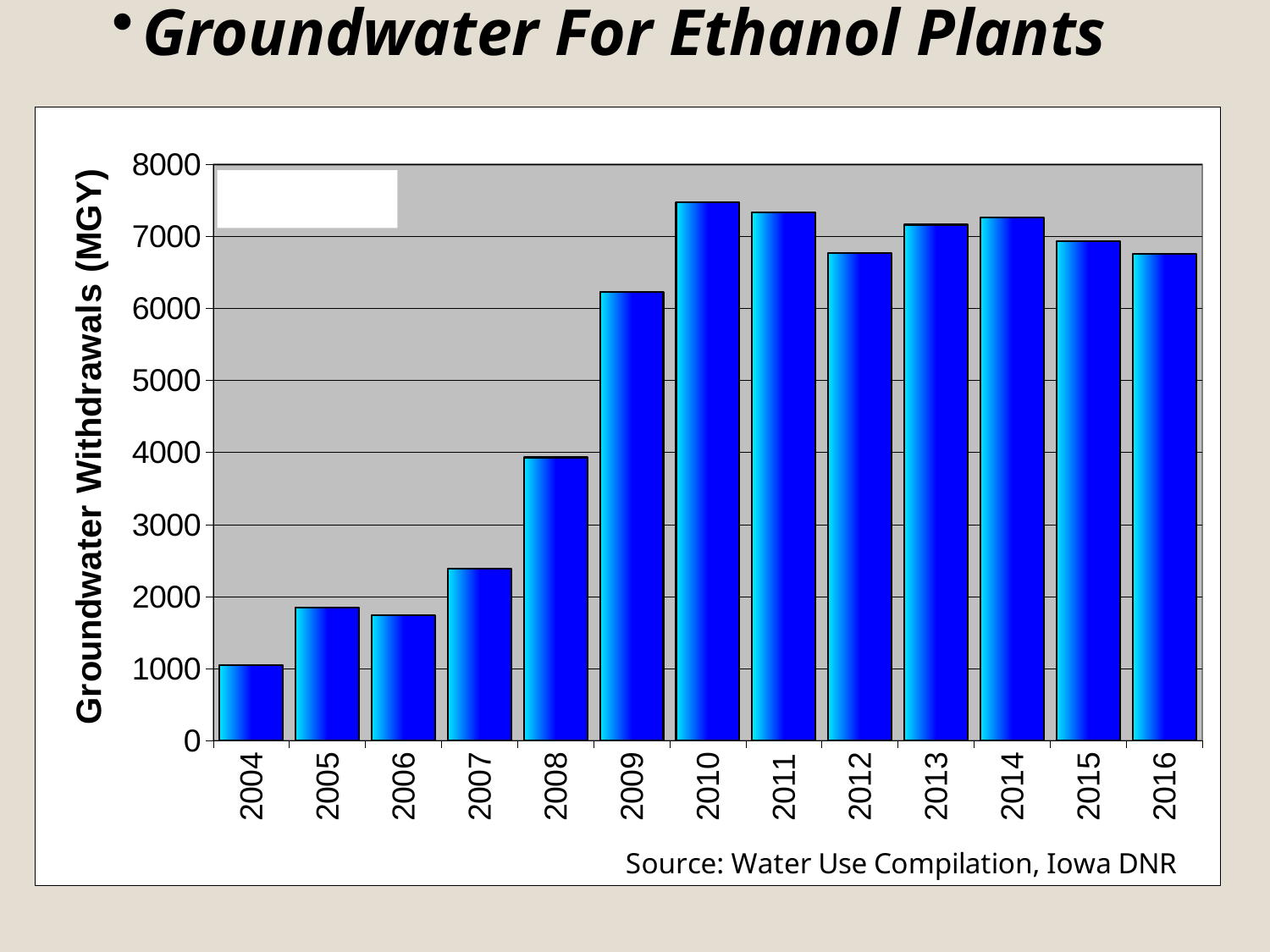
Is the value for 2008 greater or less than 3000? greater Is the value for 2012 greater or less than 7000? less Is the value for 2004 greater or less than 2000? less What kind of chart is shown on the slide? bar chart What is the label on the y axis? Groundwater Withdrawals (MGY) Do the values generally rise or fall from 2004 to 2010? rise Which year has the lowest groundwater withdrawals? 2004 Which is larger, the value for 2008 or the value for 2009? 2009 Which is larger, the value for 2010 or the value for 2012? 2010 How many years are plotted on the x axis? 13